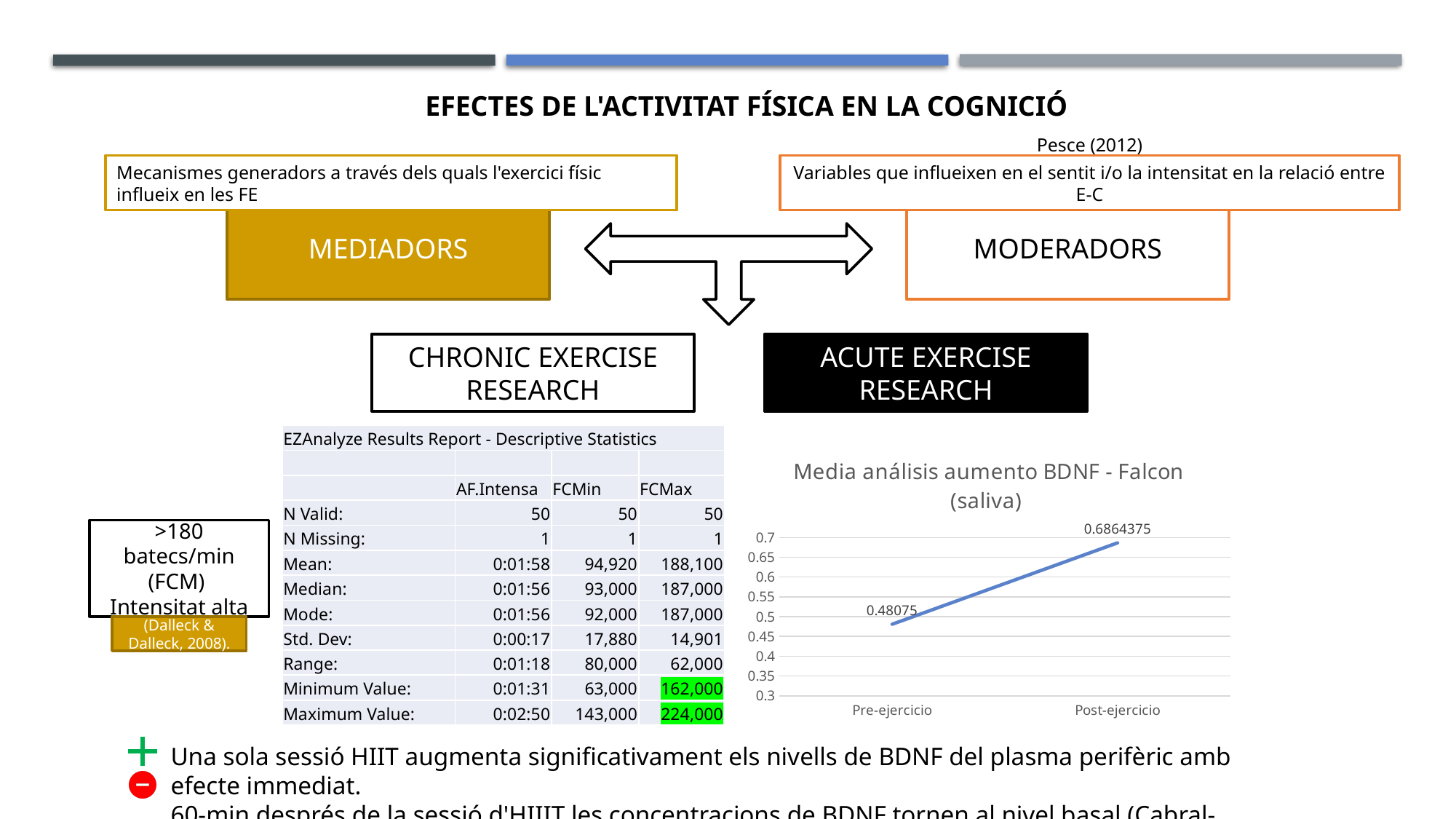
How many categories are plotted on the x axis of the chart "Media análisis aumento BDNF - Falcon (saliva)"? 2 What is the lowest value shown on the y axis of the chart "Media análisis aumento BDNF - Falcon (saliva)"? 0.3 In the chart "Media análisis aumento BDNF - Falcon (saliva)", what is the value for Post-ejercicio? 0.6864375 What type of chart is shown under the title "Media análisis aumento BDNF - Falcon (saliva)"? line chart In the chart "Media análisis aumento BDNF - Falcon (saliva)", which category has the lowest value? Pre-ejercicio In the chart "Media análisis aumento BDNF - Falcon (saliva)", what is the value for Pre-ejercicio? 0.48075 In the chart "Media análisis aumento BDNF - Falcon (saliva)", which is larger, the value for Pre-ejercicio or Post-ejercicio? Post-ejercicio In the chart "Media análisis aumento BDNF - Falcon (saliva)", is the value for Post-ejercicio greater or less than 0.65? greater In the chart "Media análisis aumento BDNF - Falcon (saliva)", does the value rise or fall from Pre-ejercicio to Post-ejercicio? rise In the chart "Media análisis aumento BDNF - Falcon (saliva)", which category has the highest value? Post-ejercicio In the chart "Media análisis aumento BDNF - Falcon (saliva)", what is the difference between the Post-ejercicio and Pre-ejercicio values? 0.2056875 In the chart "Media análisis aumento BDNF - Falcon (saliva)", is the value for Pre-ejercicio greater or less than 0.5? less